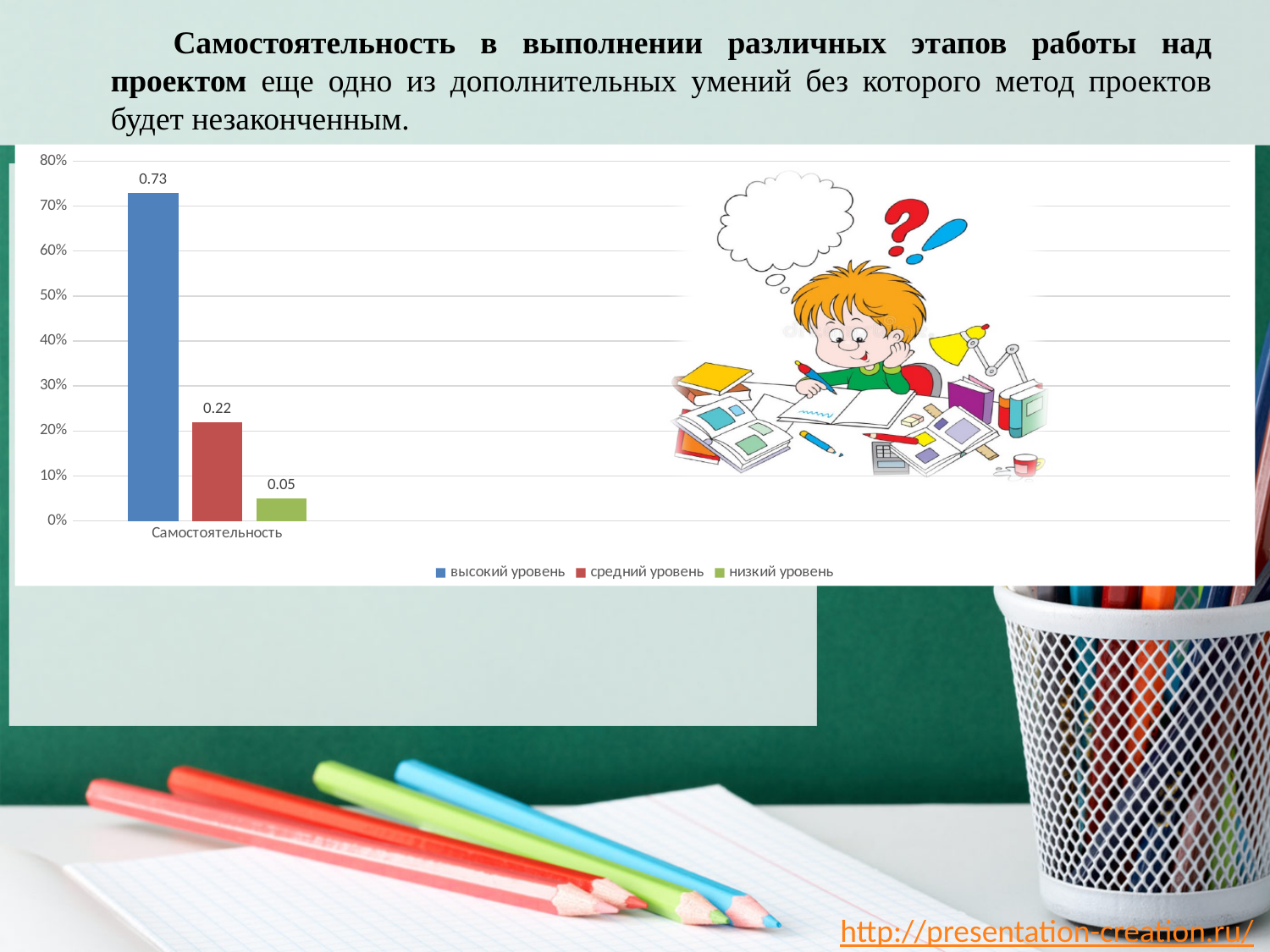
What is the value for the 'средний уровень' series in the chart? 0.22 What is the difference between the values for 'средний уровень' and 'низкий уровень'? 0.17 What is the difference between the values for 'высокий уровень' and 'средний уровень'? 0.51 What is the value for the 'низкий уровень' series in the chart? 0.05 Which is larger, the value for 'средний уровень' or the value for 'низкий уровень'? средний уровень Is the value for 'высокий уровень' greater or less than 50%? greater Which series has the highest value in the chart? высокий уровень What is the value for the 'высокий уровень' series in the chart? 0.73 What is the category label shown on the x axis of the chart? Самостоятельность How many series does the legend list? 3 Which series has the lowest value in the chart? низкий уровень What kind of chart is shown on the slide? bar chart